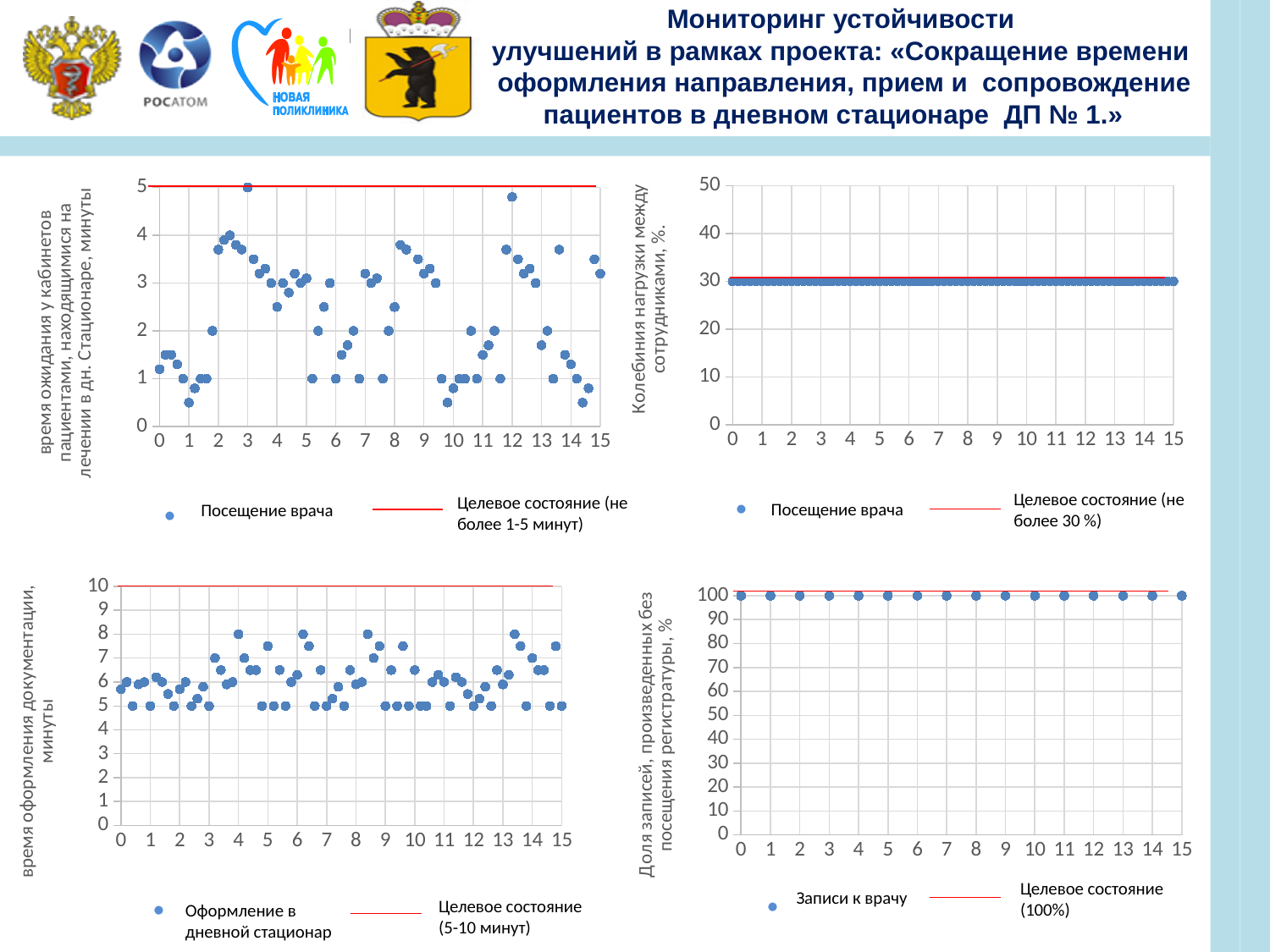
What kind of chart is the bottom-right chart? scatter chart What is the target state named in the legend of the top-right chart? Целевое состояние (не более 30 %) In the top-right chart (Колебания нагрузки между сотрудниками), are the plotted values for Посещение врача greater or less than 40? less In the top-left chart, is the highest plotted value for Посещение врача greater or less than 4? greater In the bottom-left chart, is the lowest plotted value for Оформление в дневной стационар greater or less than 4? greater What is the name of the plotted series in the legend of the bottom-right chart? Записи к врачу What kind of chart is the top-left chart (время ожидания у кабинетов)? scatter chart How many series does the legend of the top-left chart list? 2 How many series does the legend of the bottom-right chart list? 2